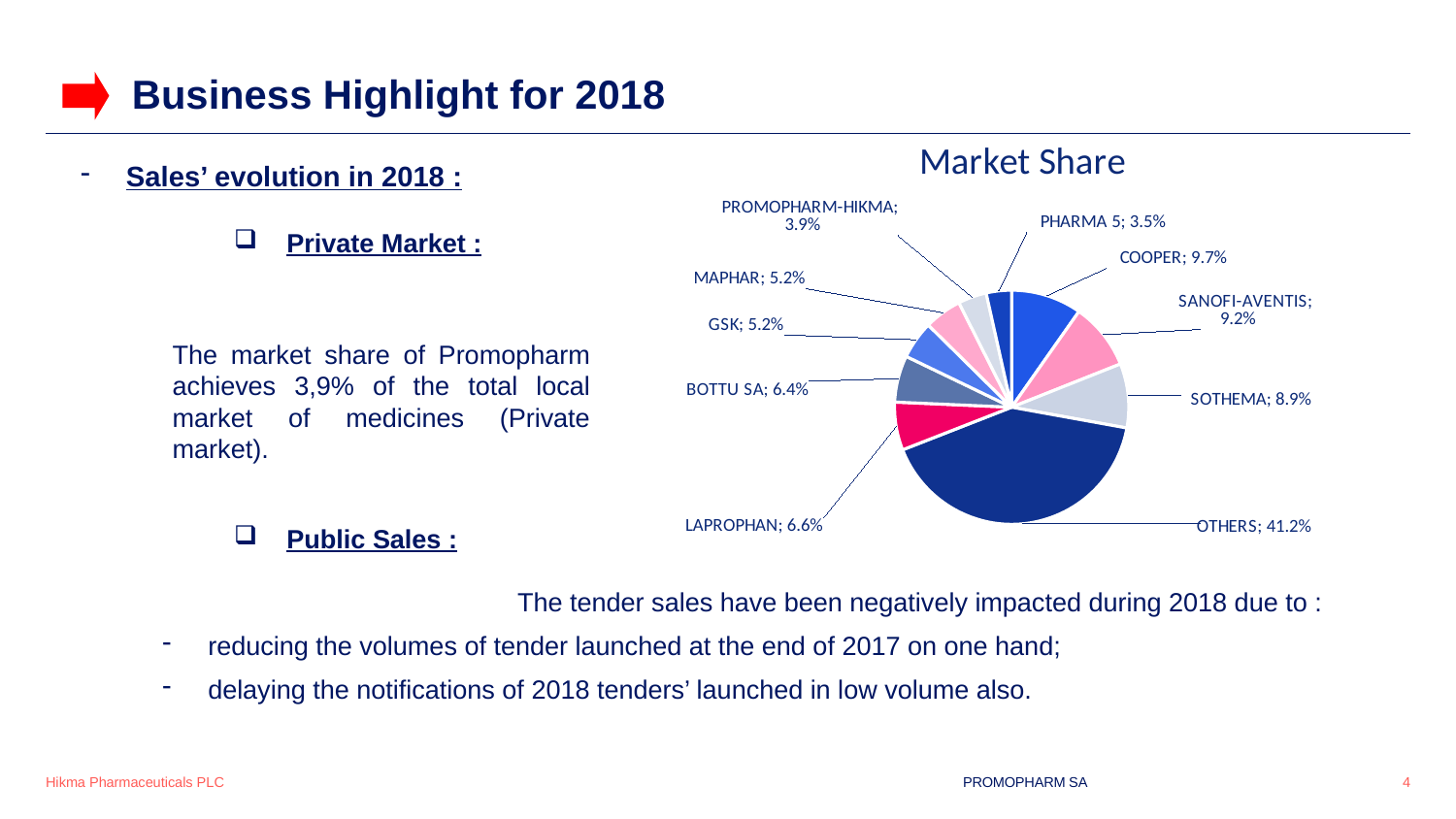
Which category has the largest slice of the pie? OTHERS What is the market share of MAPHAR? 5.2% What is the difference between the market share of SANOFI-AVENTIS and SOTHEMA? 0.3% What is the market share of PROMOPHARM-HIKMA? 3.9% What is the difference between the market share of OTHERS and COOPER? 31.5% How many slices does the pie chart have? 10 Which category has the smallest slice of the pie? PHARMA 5 What type of chart is shown on the slide? Pie chart What is the market share of COOPER? 9.7% What is the market share of LAPROPHAN? 6.6% Which has a larger market share, BOTTU SA or GSK? BOTTU SA What is the title of the chart? Market Share